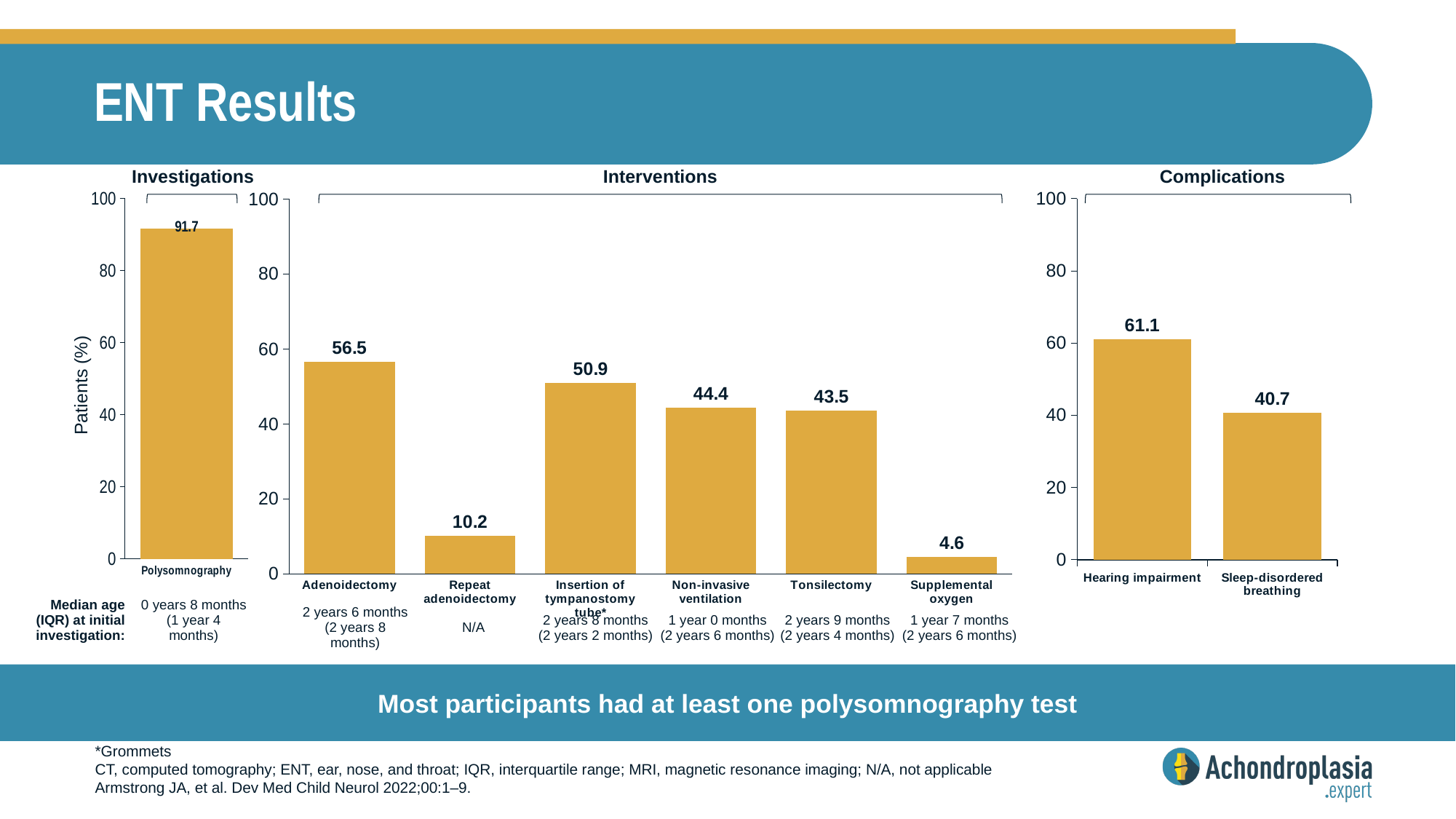
What type of chart is used for the Complications panel? Bar chart In the Interventions chart, what is the value for Tonsilectomy? 43.5 In the Interventions chart, which is larger: Insertion of tympanostomy tube or Non-invasive ventilation? Insertion of tympanostomy tube In the Interventions chart, what is the value for Supplemental oxygen? 4.6 In the Interventions chart, what is the difference between Adenoidectomy and Repeat adenoidectomy? 46.3 In the Investigations chart, what percentage of patients had polysomnography? 91.7 In the Complications chart, what is the value for Sleep-disordered breathing? 40.7 In the Interventions chart, which intervention has the lowest percentage of patients? Supplemental oxygen What is the label on the y-axis of the Investigations chart? Patients (%) How many intervention categories are shown in the Interventions chart? 6 In the Interventions chart, which intervention has the highest percentage of patients? Adenoidectomy In the Complications chart, what is the difference between Hearing impairment and Sleep-disordered breathing? 20.4